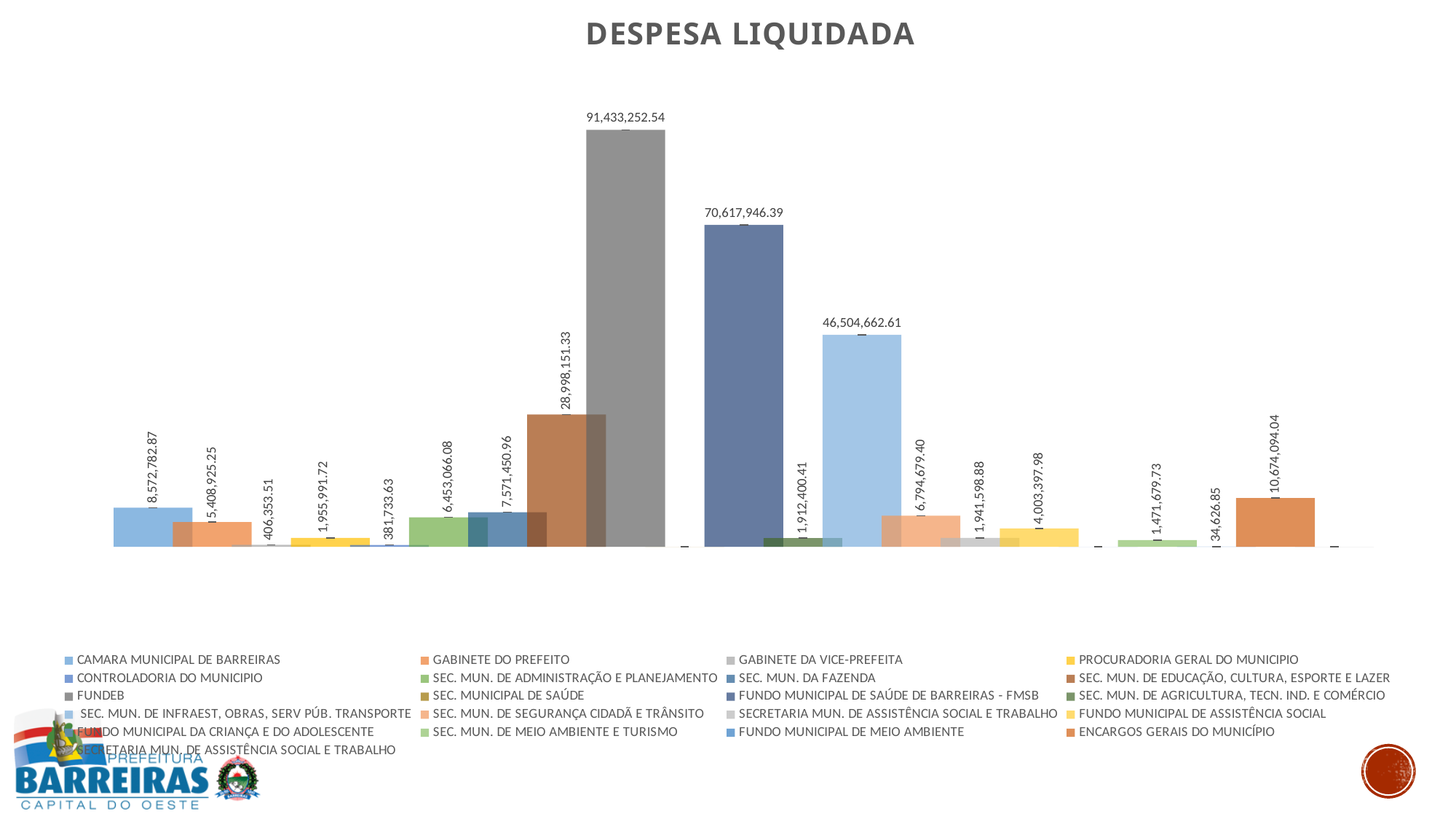
How many series does the legend list? 21 What is the value shown for SEC. MUN. DE EDUCAÇÃO, CULTURA, ESPORTE E LAZER? 28,998,151.33 What is the value shown for FUNDEB? 91,433,252.54 What type of chart is shown on the slide? bar chart Which series has the tallest bar in the chart? FUNDEB What is the value shown for FUNDO MUNICIPAL DE SAÚDE DE BARREIRAS - FMSB? 70,617,946.39 What is the value shown for SEC. MUN. DE INFRAEST, OBRAS, SERV PÚB. TRANSPORTE? 46,504,662.61 What is the difference between the values for FUNDEB and FUNDO MUNICIPAL DE SAÚDE DE BARREIRAS - FMSB? 20,815,306.15 What is the value shown for CAMARA MUNICIPAL DE BARREIRAS? 8,572,782.87 What is the title of the chart? DESPESA LIQUIDADA What is the value shown for ENCARGOS GERAIS DO MUNICÍPIO? 10,674,094.04 Which is larger, the value for GABINETE DO PREFEITO or the value for SEC. MUN. DE ADMINISTRAÇÃO E PLANEJAMENTO? SEC. MUN. DE ADMINISTRAÇÃO E PLANEJAMENTO